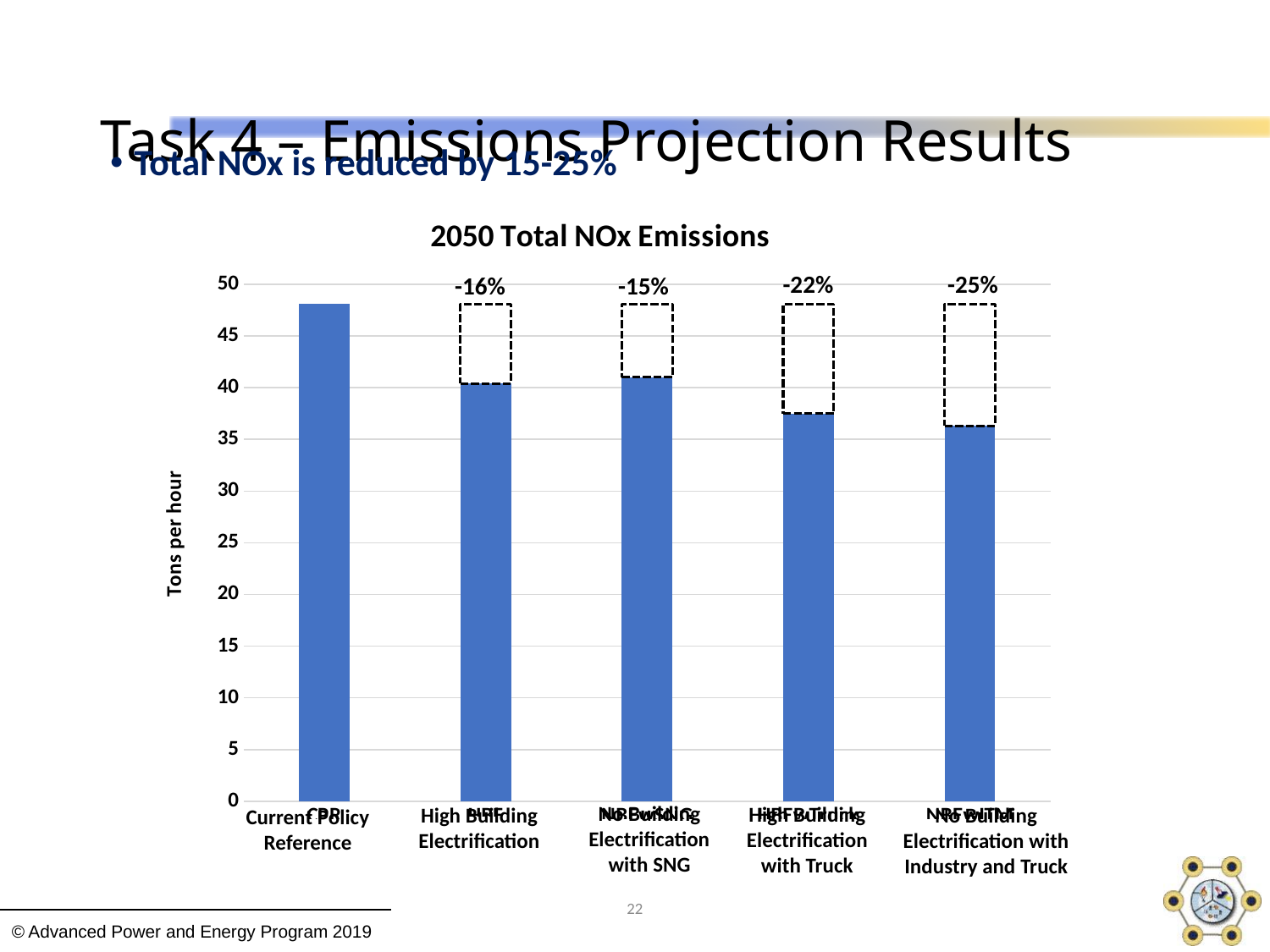
Is the value for Current Policy Reference greater or less than 45? greater What percentage reduction is shown above the High Building Electrification bar? -16% What kind of chart is shown on the slide? bar chart Which scenario has the highest 2050 total NOx emissions? Current Policy Reference What percentage reduction is shown above the High Building Electrification with Truck bar? -22% What percentage reduction is shown above the No Building Electrification with SNG bar? -15% What percentage reduction is shown above the No Building Electrification with Industry and Truck bar? -25% What is the label on the vertical axis of the chart? Tons per hour How many scenarios (categories) are plotted in the chart? 5 Which scenario has the lowest 2050 total NOx emissions? No Building Electrification with Industry and Truck Is the value for High Building Electrification with Truck greater or less than 40? less What is the title of the chart? 2050 Total NOx Emissions